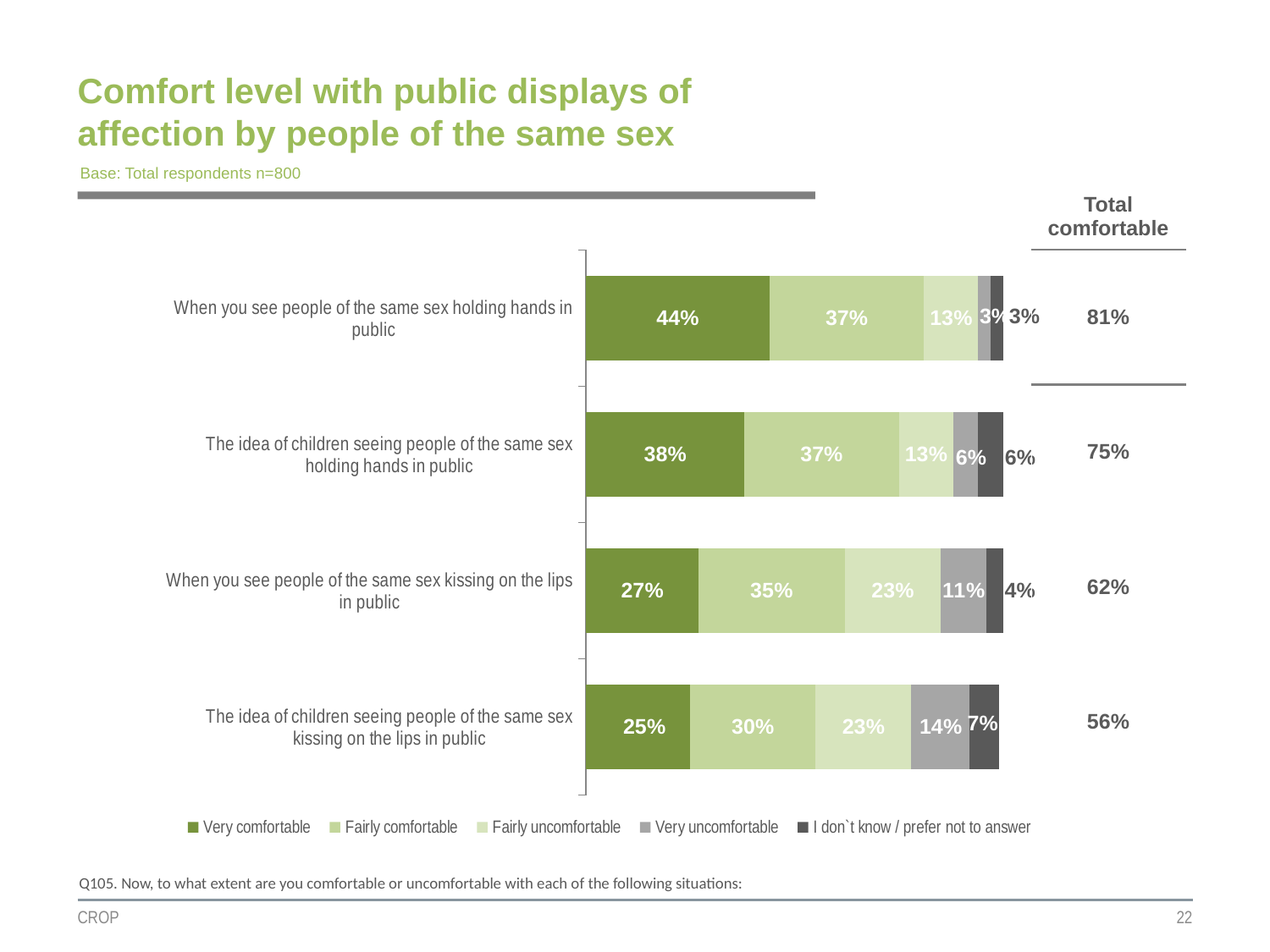
What percentage of respondents are very uncomfortable when they see people of the same sex kissing on the lips in public? 11% Which situation has the lowest share of respondents who are very comfortable? The idea of children seeing people of the same sex kissing on the lips in public What is the base (number of respondents) stated for the chart? n=800 What kind of chart is shown on the slide? Stacked bar chart How many series does the legend list? 5 Which is larger: the very comfortable share for seeing people of the same sex kissing on the lips in public, or the very comfortable share for the idea of children seeing people of the same sex holding hands in public? The idea of children seeing people of the same sex holding hands in public What percentage of respondents are fairly uncomfortable with the idea of children seeing people of the same sex kissing on the lips in public? 23% What is the difference between the 'Total comfortable' percentages for seeing people of the same sex holding hands in public and seeing them kissing on the lips in public? 19% What is the 'Total comfortable' figure for the idea of children seeing people of the same sex holding hands in public? 75% Which situation has the highest 'Total comfortable' percentage? When you see people of the same sex holding hands in public How many situations (categories) are shown in the chart? 4 What percentage of respondents are very comfortable when they see people of the same sex holding hands in public? 44%